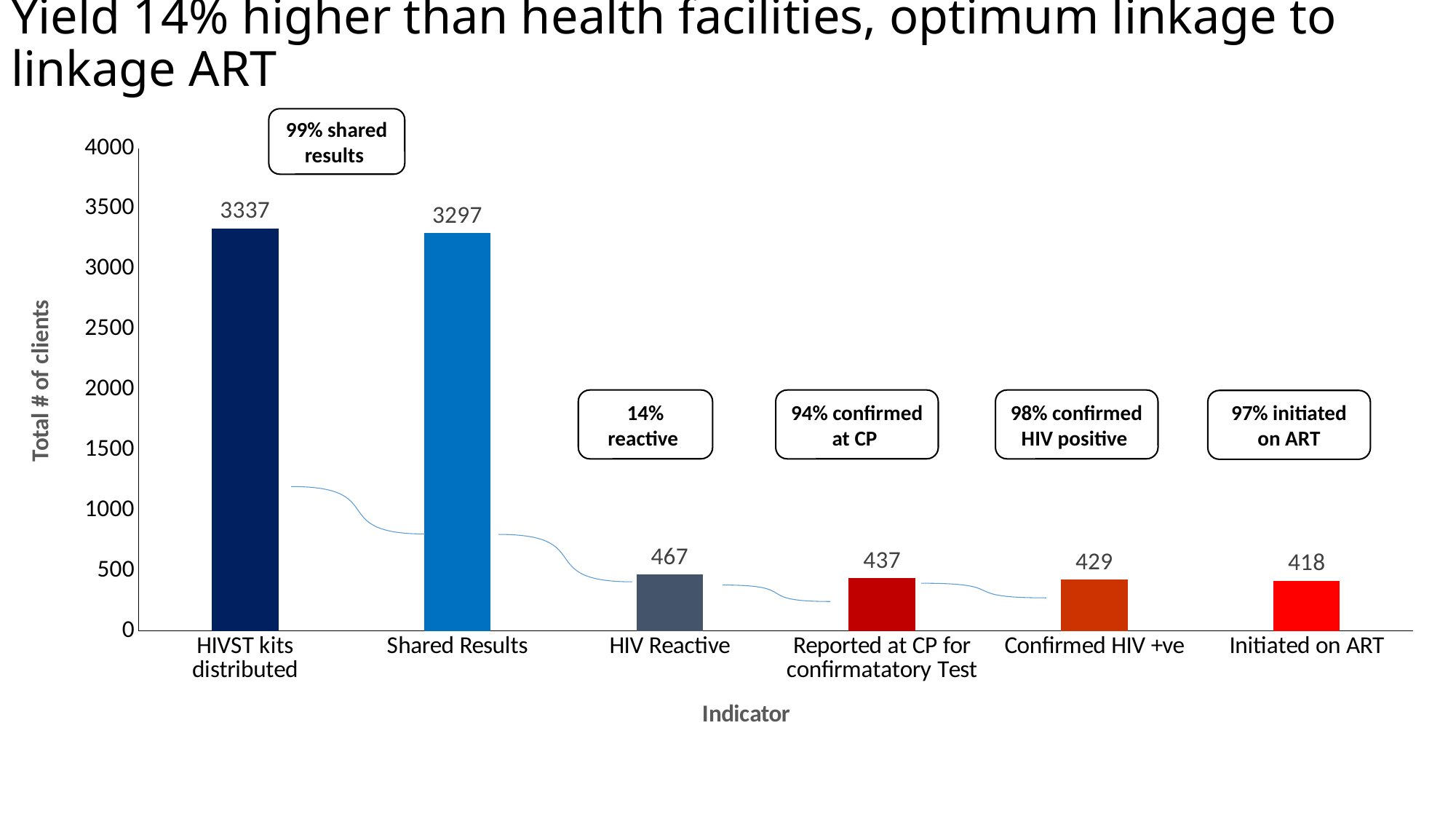
What is the difference between HIVST kits distributed and Shared Results? 40 How many categories are shown on the x axis? 6 What is the value for HIV Reactive? 467 What is the value for Shared Results? 3297 Which category has the highest value? HIVST kits distributed Which category has the lowest value? Initiated on ART What kind of chart is shown? Bar chart What is the value for Initiated on ART? 418 What is the difference between HIV Reactive and Reported at CP for confirmatatory Test? 30 What is the label of the y axis? Total # of clients Which is larger, Confirmed HIV +ve or Initiated on ART? Confirmed HIV +ve What is the value for HIVST kits distributed? 3337